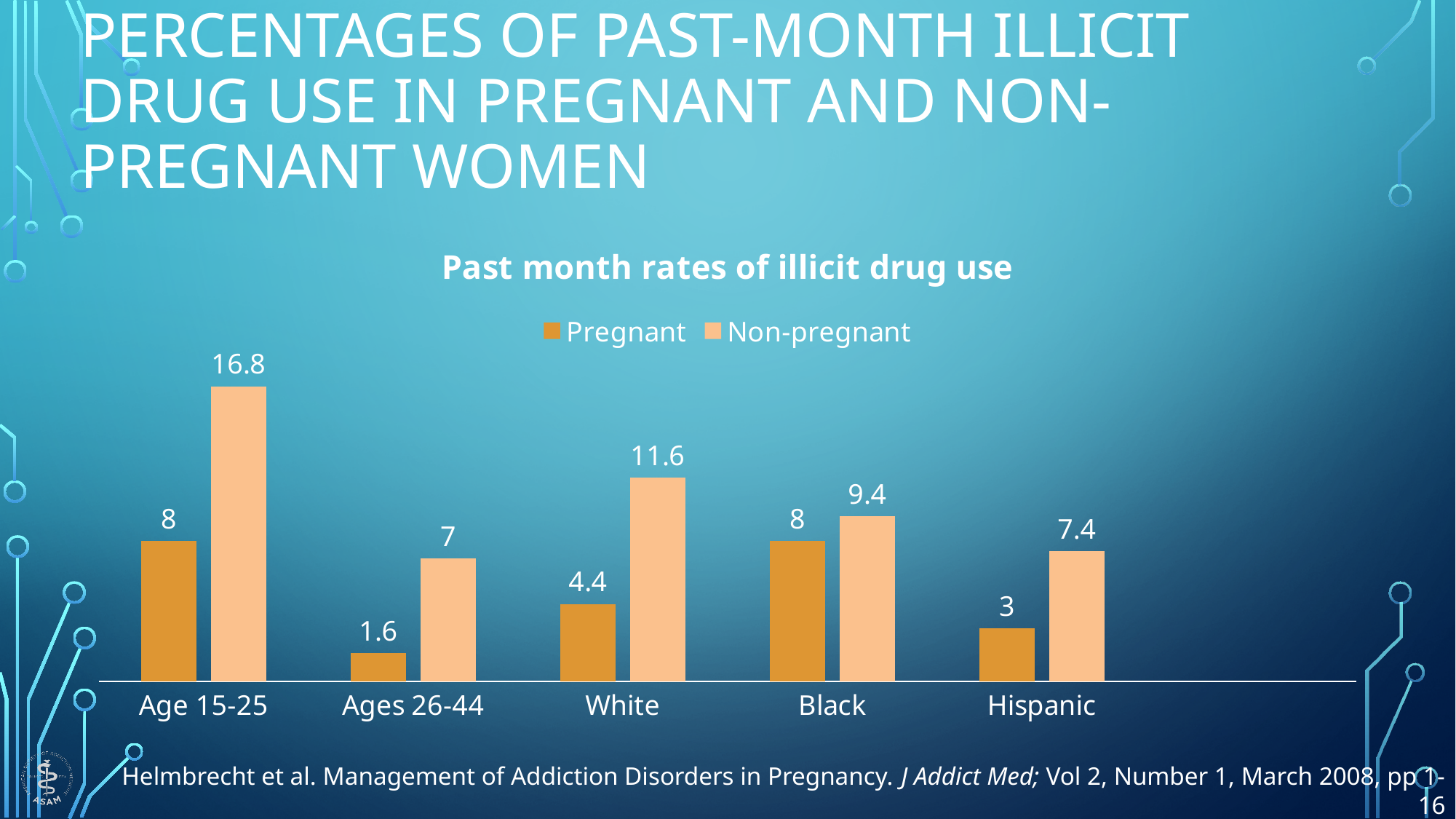
What is the Non-pregnant value for Age 15-25? 16.8 What is the difference between the Non-pregnant and Pregnant values for Black? 1.4 How many series does the legend list? 2 What is the Pregnant value for White? 4.4 Which category has the highest Non-pregnant value? Age 15-25 What is the title of the chart? Past month rates of illicit drug use What kind of chart is shown? Bar chart What is the Non-pregnant value for Hispanic? 7.4 Which is larger, the Pregnant value for Black or the Pregnant value for Hispanic? Black What is the Pregnant value for Ages 26-44? 1.6 How many categories are shown on the x axis? 5 Which category has the lowest Pregnant value? Ages 26-44